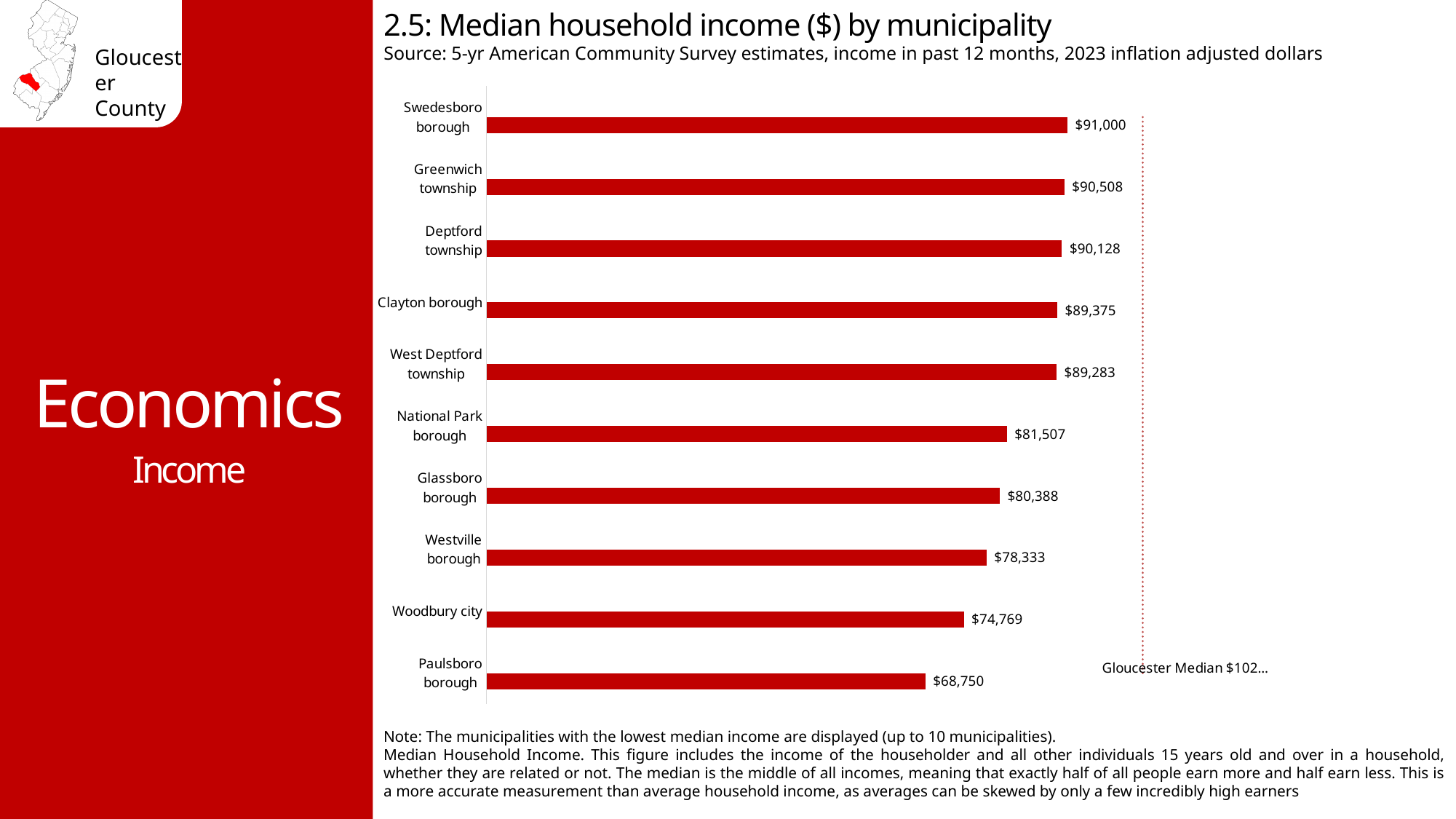
What is the title of the chart? 2.5: Median household income ($) by municipality What is the median household income for Glassboro borough? $80,388 What is the median household income for Paulsboro borough? $68,750 Which municipality has the highest median household income shown on the chart? Swedesboro borough What is the difference in median household income between Swedesboro borough and Paulsboro borough? $22,250 What is the median household income for Woodbury city? $74,769 Which municipality has the lowest median household income shown on the chart? Paulsboro borough What is the difference in median household income between National Park borough and Glassboro borough? $1,119 What kind of chart is used to show median household income by municipality? Bar chart How many municipalities are shown on the chart? 10 Which has a higher median household income, Westville borough or Woodbury city? Westville borough What is the median household income for Swedesboro borough? $91,000